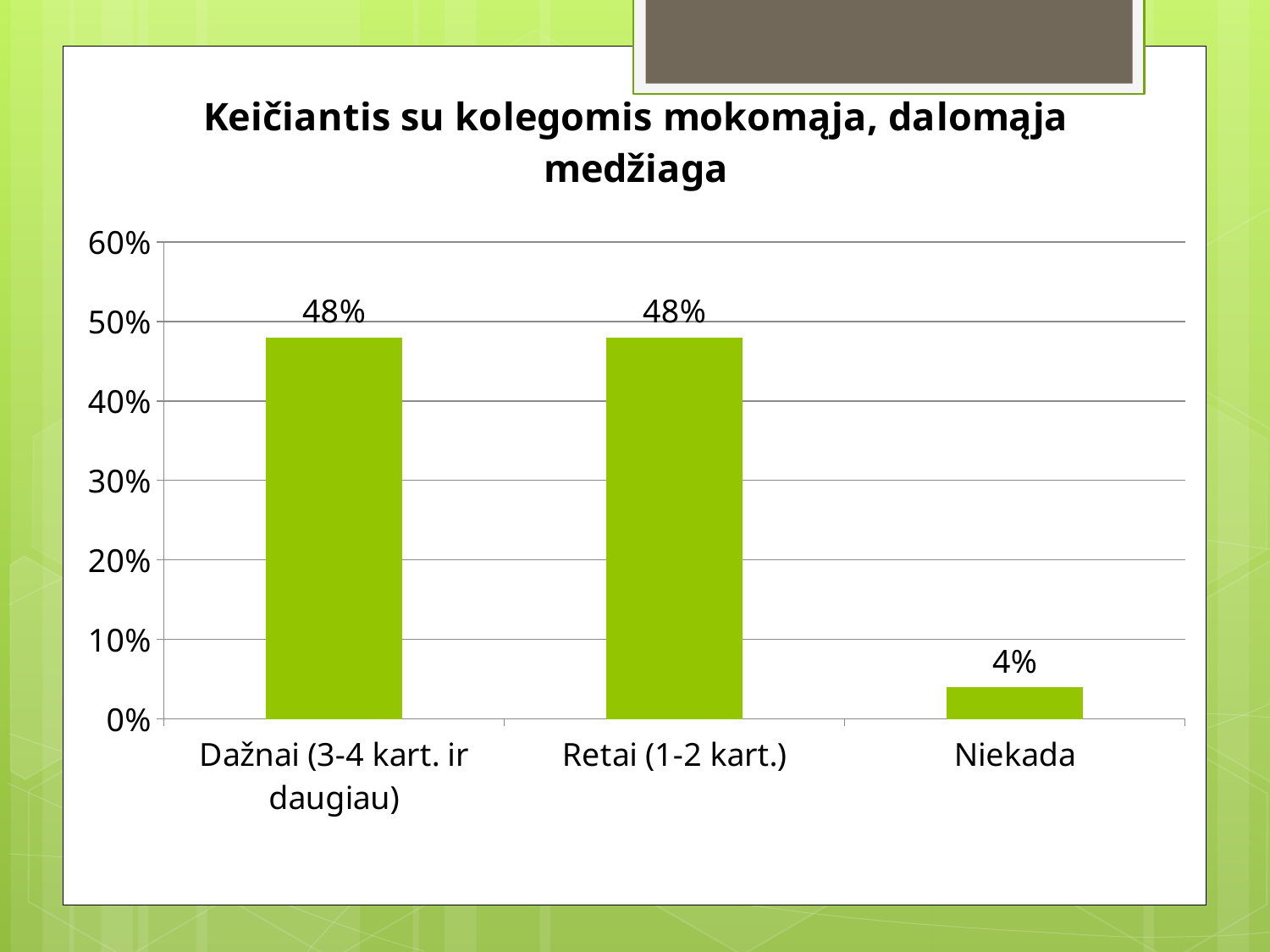
What is the value for Retai (1-2 kart.)? 48% Is the value for Niekada greater or less than 10%? less Which is larger, the value for Dažnai (3-4 kart. ir daugiau) or the value for Niekada? Dažnai (3-4 kart. ir daugiau) Which category has the lowest value? Niekada What is the value for Dažnai (3-4 kart. ir daugiau)? 48% What is the title of the chart? Keičiantis su kolegomis mokomąja, dalomąja medžiaga What is the value for Niekada? 4% What kind of chart is shown on the slide? bar chart What is the highest value shown on the y axis? 60% How many categories are shown on the x axis? 3 What is the difference between the values for Retai (1-2 kart.) and Niekada? 44% Is the value for Retai (1-2 kart.) greater or less than 40%? greater